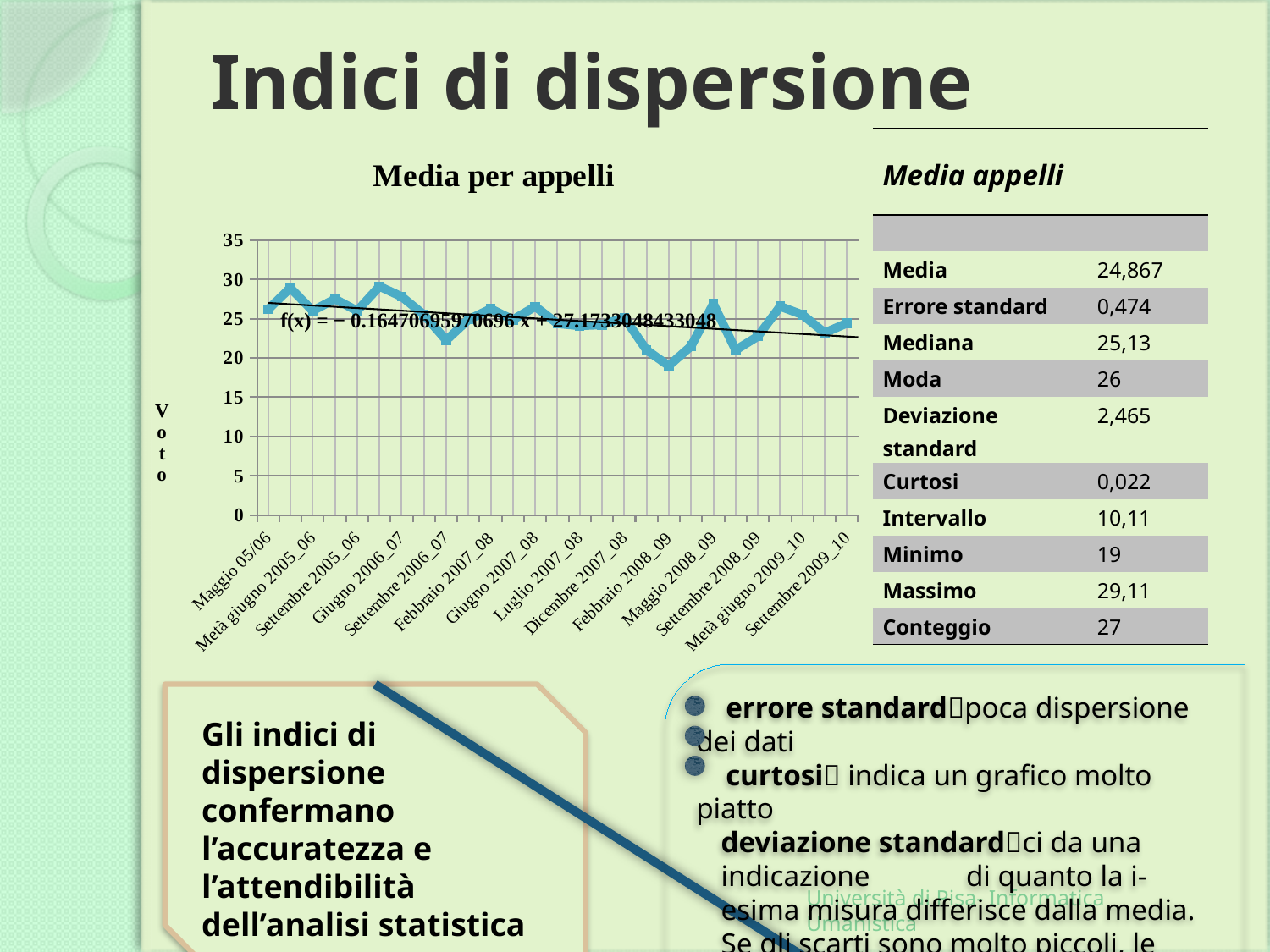
What kind of chart is "Media per appelli"? line chart In the "Media per appelli" chart, which is larger: the value for Maggio 05/06 or the value for Febbraio 2008_09? Maggio 05/06 In the "Media per appelli" chart, is the value for Febbraio 2008_09 greater or less than 20? less How many category labels are printed along the x axis of the "Media per appelli" chart? 14 In the "Media per appelli" chart, do the values generally rise or fall from left to right along the x axis? fall What is the label of the vertical axis of the "Media per appelli" chart? Voto What is the highest value shown on the vertical axis of the "Media per appelli" chart? 35 What is the title of the chart on the slide? Media per appelli In the "Media per appelli" chart, is the value for Settembre 2009_10 greater or less than 20? greater In the "Media per appelli" chart, is the value for Giugno 2006_07 greater or less than 25? greater In the "Media per appelli" chart, which labelled category has the lowest value? Febbraio 2008_09